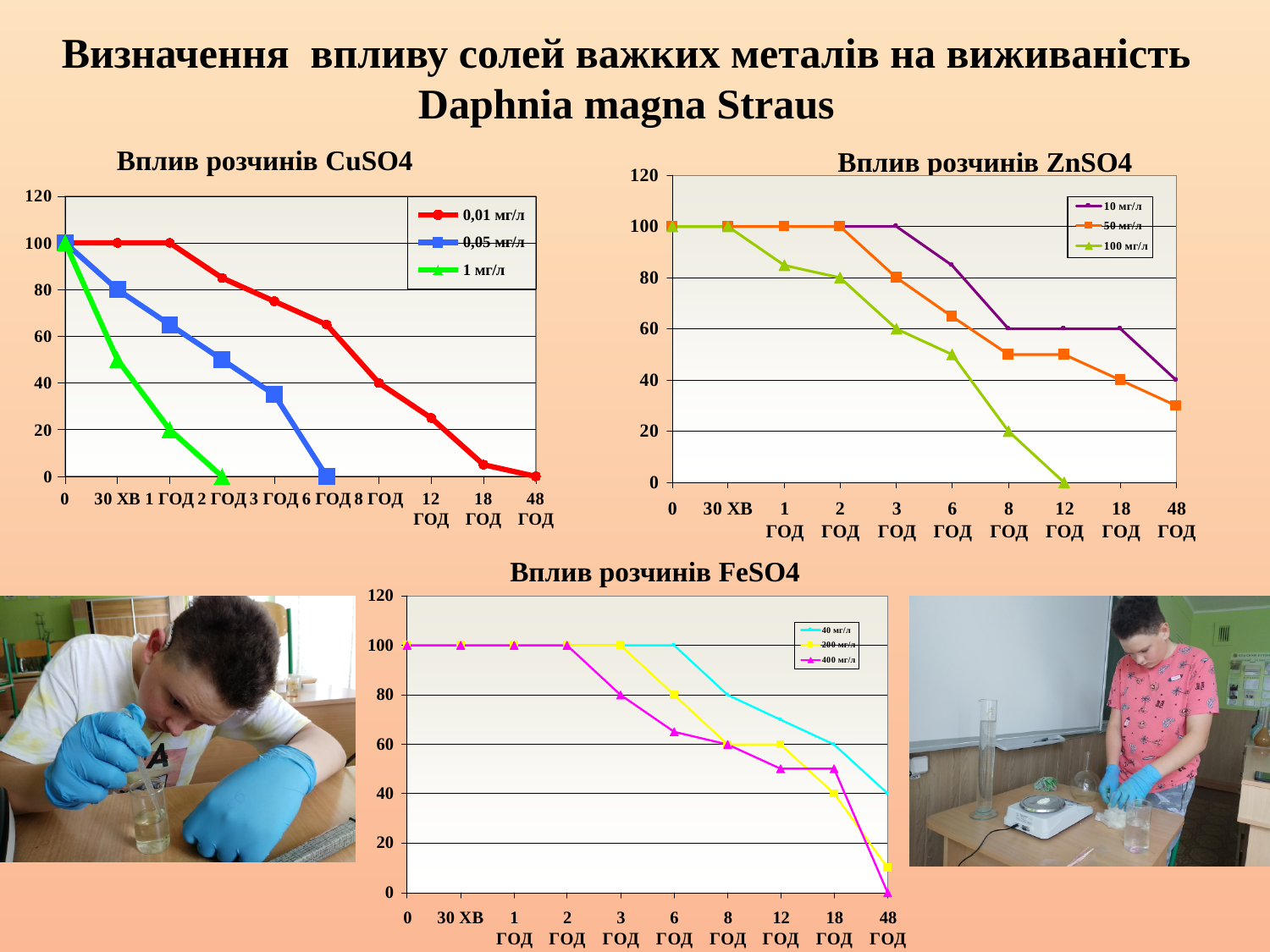
In the 'Вплив розчинів ZnSO4' chart, what is the value of the 10 мг/л series at 48 год? 40 In the 'Вплив розчинів CuSO4' chart, is the value of the 0,01 мг/л series at 3 год greater or less than 60? greater What is the title of the chart at the bottom centre of the slide? Вплив розчинів FeSO4 How many points along the x axis does the 'Вплив розчинів FeSO4' chart have? 10 In the 'Вплив розчинів ZnSO4' chart, which series is higher at 8 год: 10 мг/л or 50 мг/л? 10 мг/л What kind of chart is the 'Вплив розчинів CuSO4' chart? line chart In the 'Вплив розчинів CuSO4' chart, what is the value of the 1 мг/л series at 2 год? 0 In the 'Вплив розчинів CuSO4' chart, what is the value of the 0,05 мг/л series at 30 хв? 80 How many series does the legend of the 'Вплив розчинів ZnSO4' chart list? 3 In the 'Вплив розчинів FeSO4' chart, what is the value of the 40 мг/л series at 18 год? 60 In the 'Вплив розчинів ZnSO4' chart, what is the value of the 100 мг/л series at 12 год? 0 In the 'Вплив розчинів FeSO4' chart, do the values of the 400 мг/л series rise or fall along the x axis? fall